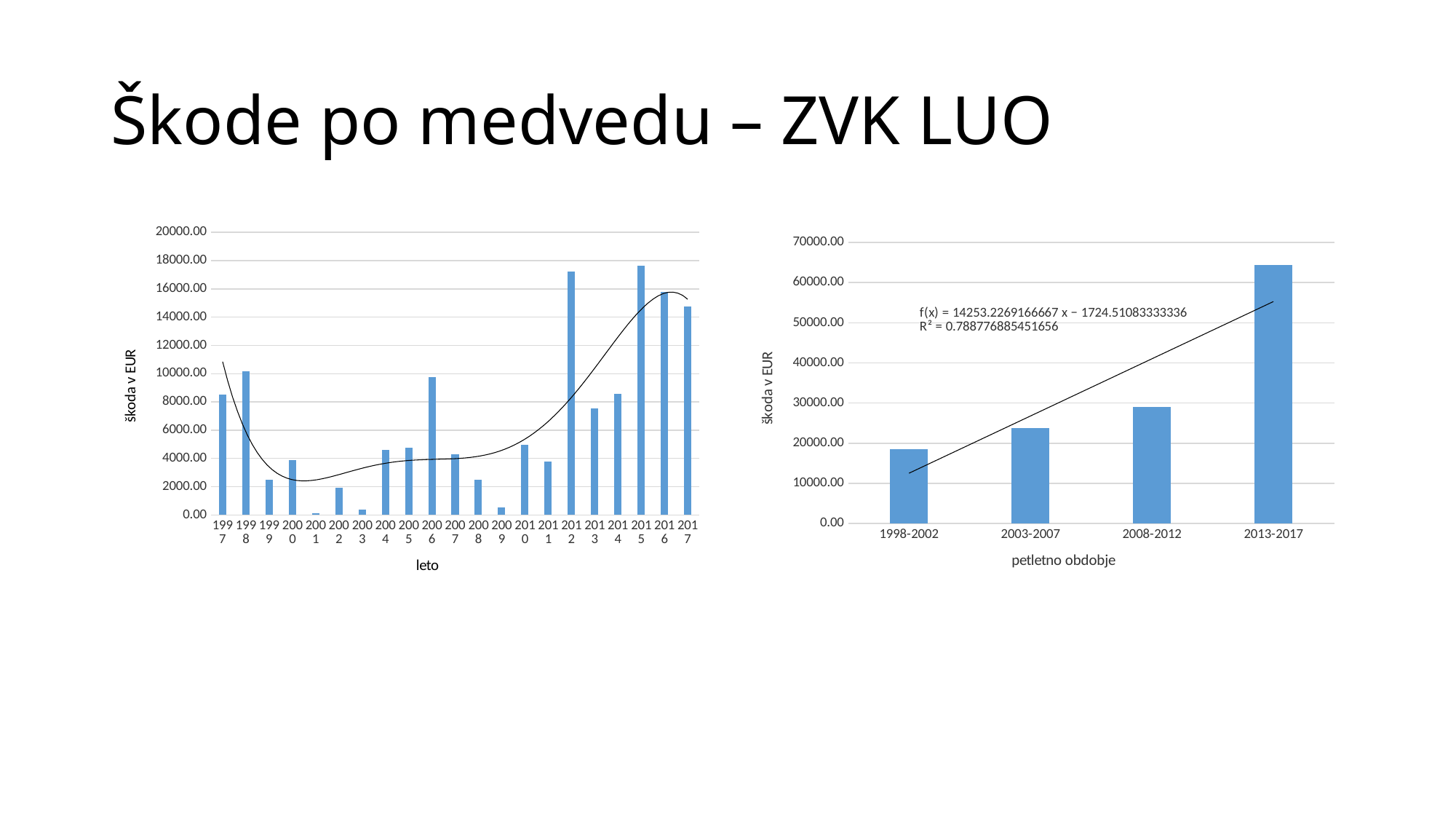
In the right chart, which period has the lowest value? 1998-2002 What R² value is printed on the right chart? 0.788776885451656 In the right chart, is the value for 2013-2017 greater or less than 60000? greater In the left chart, which year has the lowest value? 2001 What kind of chart is the left chart (by year)? bar chart In the left chart, is the value for 2006 greater or less than 8000? greater In the right chart, do the values rise or fall from 1998-2002 to 2013-2017? rise How many bars (years) does the left chart show? 21 In the left chart, is the value for 2012 greater or less than 16000? greater In the right chart (petletno obdobje), which period has the highest value? 2013-2017 In the left chart, which is larger, the value for 2015 or the value for 2017? 2015